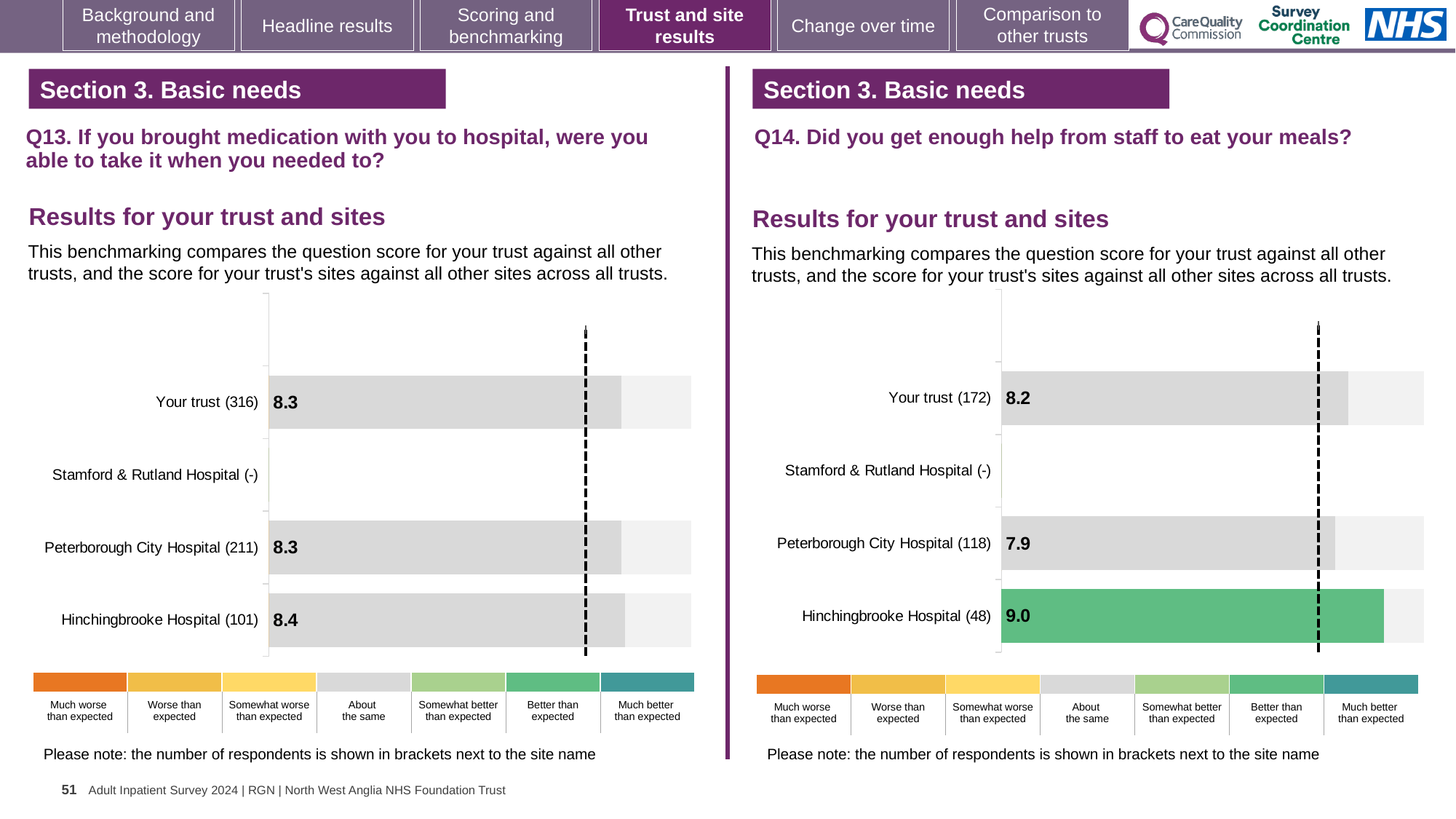
In the Q13 chart on the left, how many respondents are shown in brackets for Your trust? 316 In the Q14 chart on the right, which has the larger score, Your trust or Hinchingbrooke Hospital? Hinchingbrooke Hospital In the Q14 chart on the right, what is the difference between the scores for Hinchingbrooke Hospital and Peterborough City Hospital? 1.1 What kind of chart is the Q14 chart on the right? Bar chart In the Q14 chart on the right, what is the score for Peterborough City Hospital? 7.9 In the Q14 chart on the right, which site has the highest score? Hinchingbrooke Hospital In the Q13 chart on the left, what is the score for Peterborough City Hospital? 8.3 In the Q14 chart on the right, what colour is the bar for Hinchingbrooke Hospital? Green In the Q13 chart on the left, what is the score for Your trust? 8.3 In the Q14 chart on the right, which site with a plotted score has the lowest score? Peterborough City Hospital In the Q13 chart on the left, what is the score for Hinchingbrooke Hospital? 8.4 In the Q14 chart on the right, what is the score for Your trust? 8.2